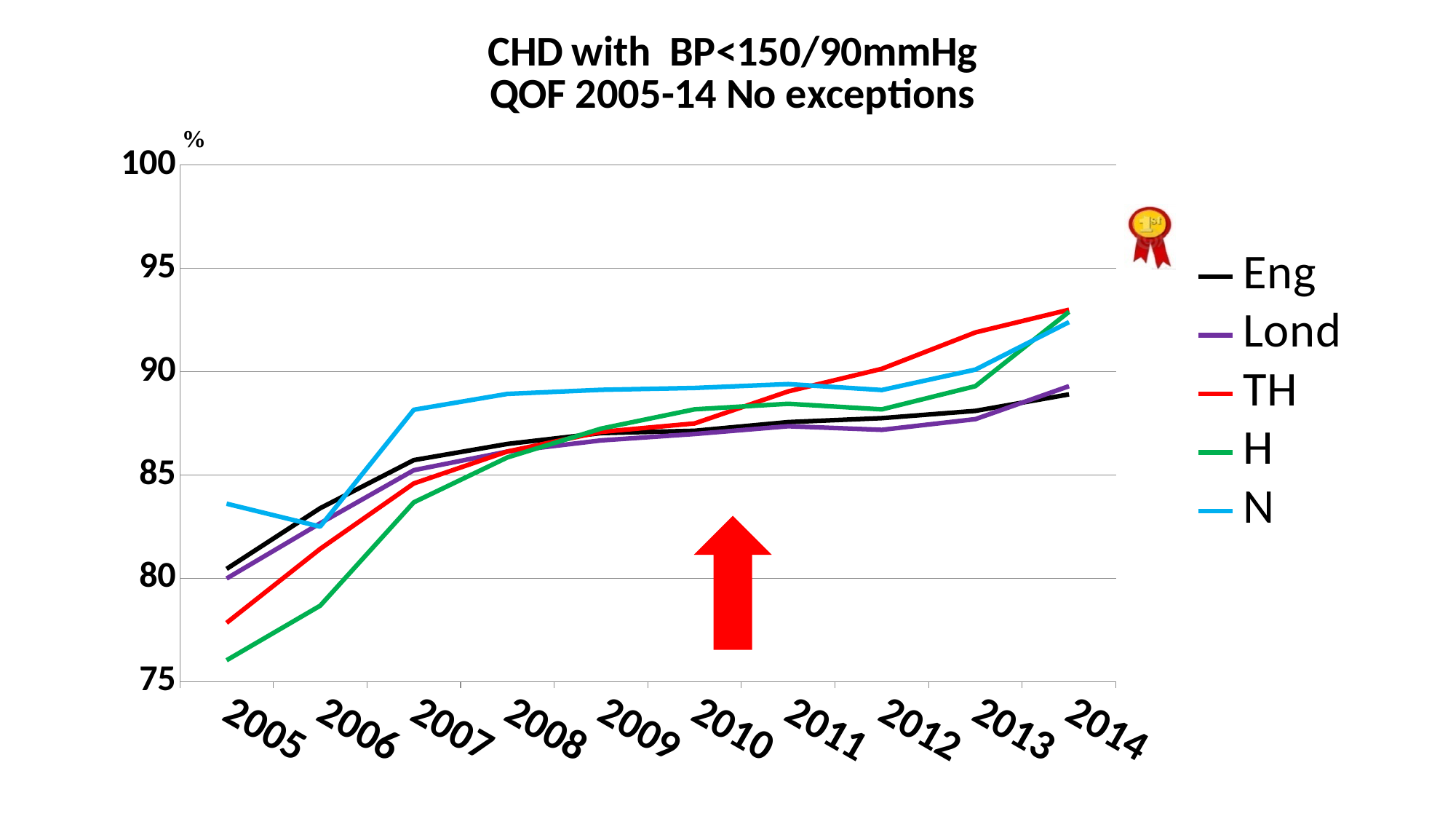
Which series has the highest value in 2005? N Is the value for H in 2005 greater or less than 80? less How many series does the legend list? 5 Is the value for TH in 2013 greater or less than 90? greater What colour is the line for TH in the legend? red What kind of chart is shown on the slide? line chart Does the TH series rise or fall from 2005 to 2014? rise How many years are plotted along the x axis? 10 Which series has the lowest value in 2005? H In 2005, which is higher, Eng or TH? Eng Is the value for Eng in 2014 greater or less than 90? less Which series has the highest value in 2013? TH